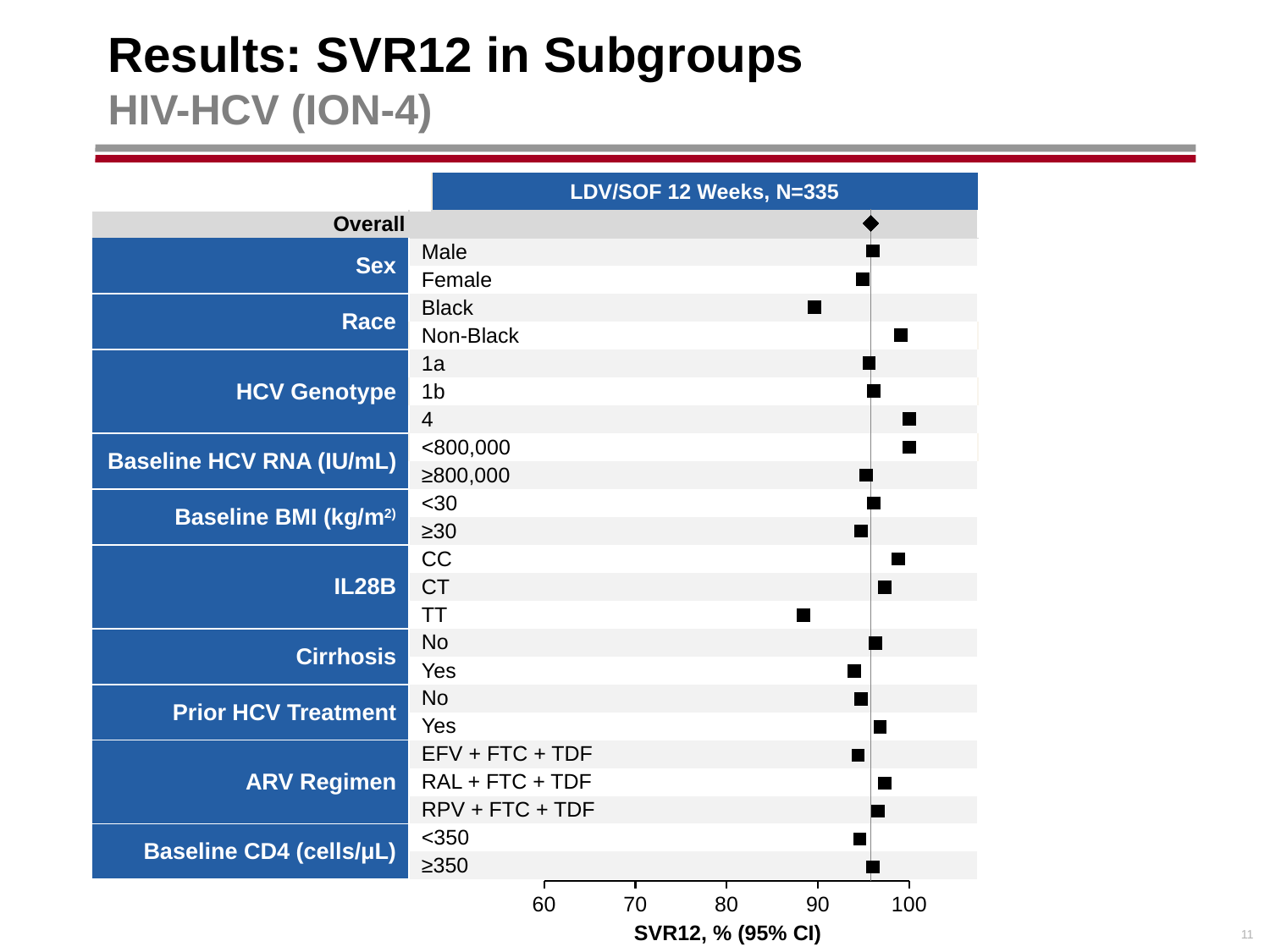
Which HCV genotype subgroup has the higher SVR12, 1a or 4? 4 Is the SVR12 value for the IL28B TT subgroup greater or less than 90? less Is the SVR12 value for the Non-Black subgroup greater or less than 90? greater What is the N shown in the column header for the LDV/SOF 12 Weeks group? 335 Which race subgroup has the higher SVR12, Black or Non-Black? Non-Black What is the label of the x axis? SVR12, % (95% CI) Which subgroup on the whole chart has the lowest SVR12 point estimate? IL28B TT How many ARV Regimen subgroups are plotted? 3 Which ARV regimen has the higher SVR12, EFV + FTC + TDF or RAL + FTC + TDF? RAL + FTC + TDF How many subgroup categories (blue row headers, excluding Overall) are listed on the left of the chart? 10 Among the IL28B subgroups (CC, CT, TT), which has the lowest SVR12? TT What kind of chart is shown on the slide? Forest plot (dot plot of point estimates)